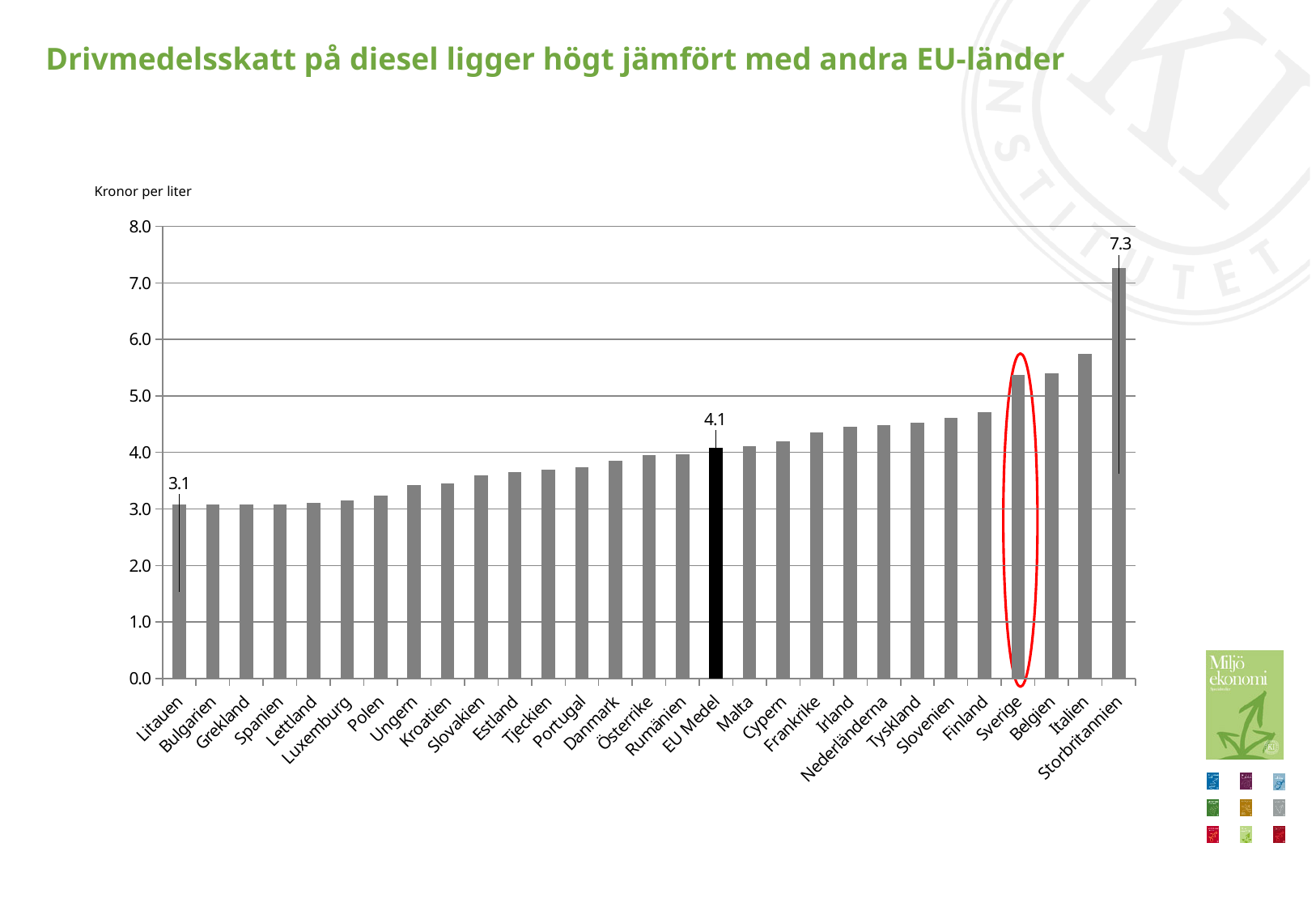
Which is larger, the value for Sverige or the value for Finland? Sverige What is the value for Storbritannien? 7.3 What is the value for Litauen? 3.1 How many categories are shown on the x axis? 29 Is the value for Polen greater or less than 4.0? less What is the difference between the values for Storbritannien and EU Medel? 3.2 What is the value for EU Medel? 4.1 Which country has the highest value? Storbritannien Which bar is circled in red? Sverige Is the value for Sverige greater or less than 5.0? greater What is the difference between the values for Storbritannien and Litauen? 4.2 What kind of chart is shown on the slide? bar chart